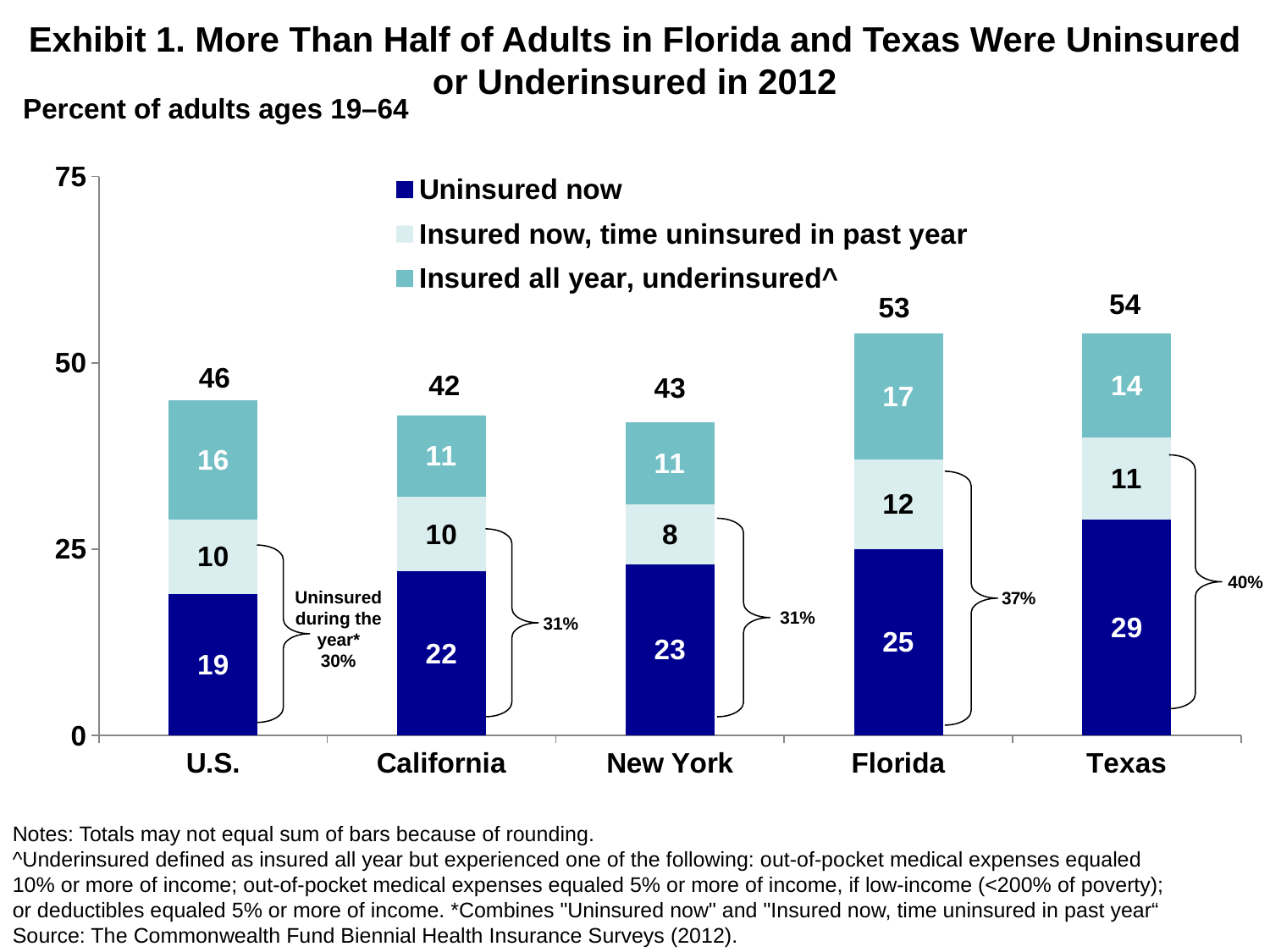
What is the value for "Insured now, time uninsured in past year" in New York? 8 What is the value for "Insured all year, underinsured^" in Florida? 17 What is the value for "Uninsured now" in Texas? 29 Which category has the highest total printed above its bar? Texas Which category has the lowest total printed above its bar? California How many categories are shown on the x axis? 5 What is the total printed above the Florida bar? 53 What is the difference between the "Uninsured now" values for Texas and the U.S.? 10 What percentage is shown by the bracket for "Uninsured during the year*" in Florida? 37% How many series does the legend list? 3 Which is larger, the "Insured all year, underinsured^" value for the U.S. or for California? U.S. What type of chart is shown on the slide? Stacked bar chart